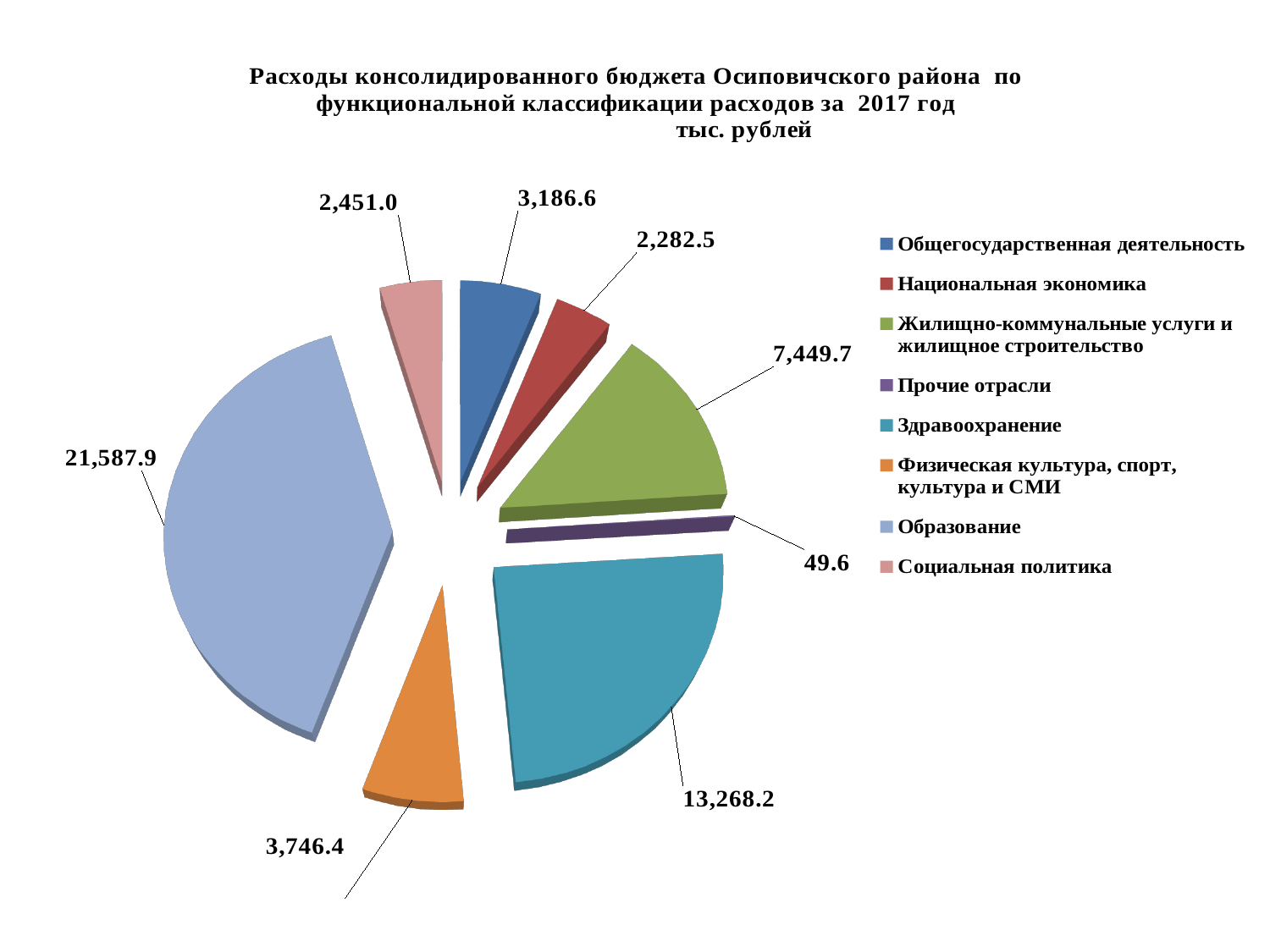
What is the difference between the values for Общегосударственная деятельность and Национальная экономика? 904.1 Which is larger, the value for Физическая культура, спорт, культура и СМИ or the value for Социальная политика? Физическая культура, спорт, культура и СМИ How many categories does the legend list? 8 What colour is the slice for Здравоохранение? Teal What is the value for Здравоохранение? 13,268.2 What is the value for Образование? 21,587.9 Which category has the largest slice of the pie? Образование What is the value for Жилищно-коммунальные услуги и жилищное строительство? 7,449.7 Which category has the smallest slice of the pie? Прочие отрасли What kind of chart is shown on the slide? Pie chart What is the value for Прочие отрасли? 49.6 What is the difference between the values for Образование and Здравоохранение? 8,319.7